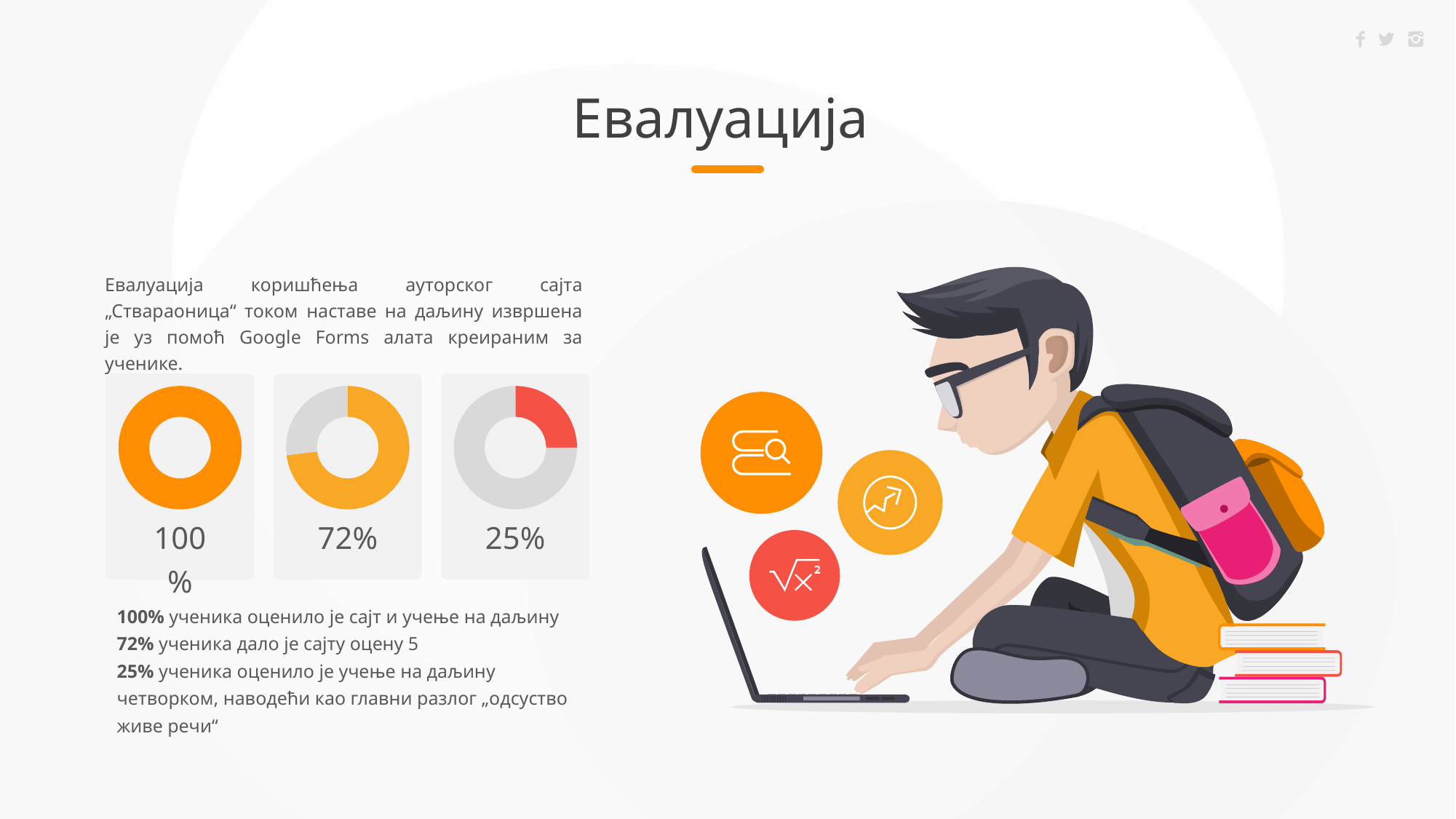
What value is shown below the right donut chart? 25% What colour is the filled portion of the right donut chart? red Which of the three donut charts shows the lowest value? the right chart (25%) What is the difference between the value of the middle donut chart and the value of the right donut chart? 47% Is the value of the middle donut chart larger or smaller than the value of the right donut chart? larger What value is shown below the middle donut chart? 72% How many donut charts are shown on the slide? 3 What is the difference between the value of the left donut chart and the value of the middle donut chart? 28% What colour is the filled portion of the left donut chart? orange What kind of chart is the left chart on the slide? donut chart What value is shown below the left donut chart? 100% Which of the three donut charts shows the highest value? the left chart (100%)